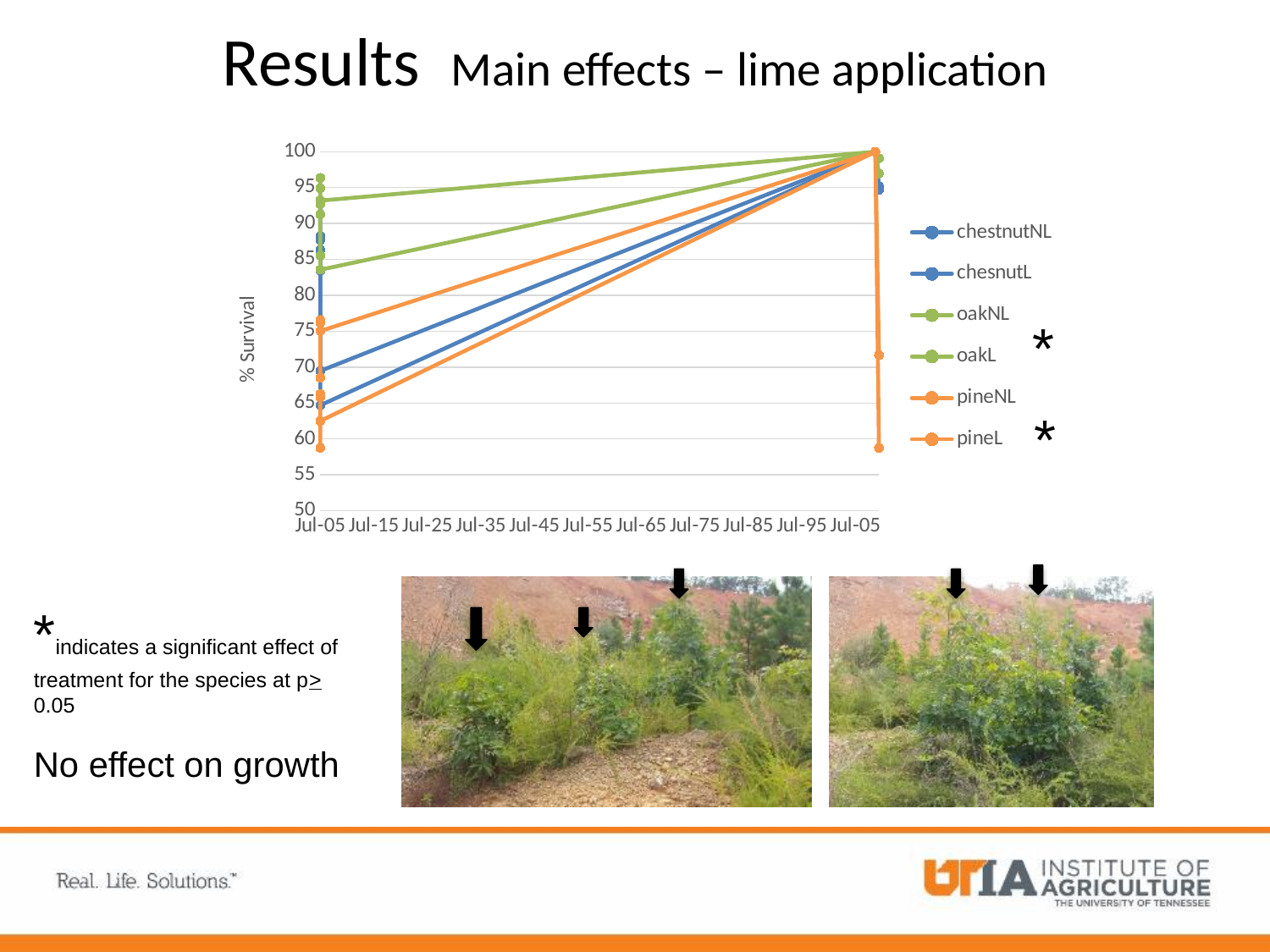
What is the lowest value shown on the y axis of the chart? 50 At the left end of the chart, are the values for the chestnut series (blue lines) greater or less than 80? less What kind of chart is shown on the slide? line chart At the left end of the chart, are the values for the oak series (green lines) greater or less than 75? greater What % Survival value do all the series reach at the right end of the chart? 100 How many series does the chart legend list? 6 Do the survival lines rise or fall moving from left to right along the x axis? rise What is the label on the y axis of the chart? % Survival Which two legend entries are marked with an asterisk next to them? oakL and pineL